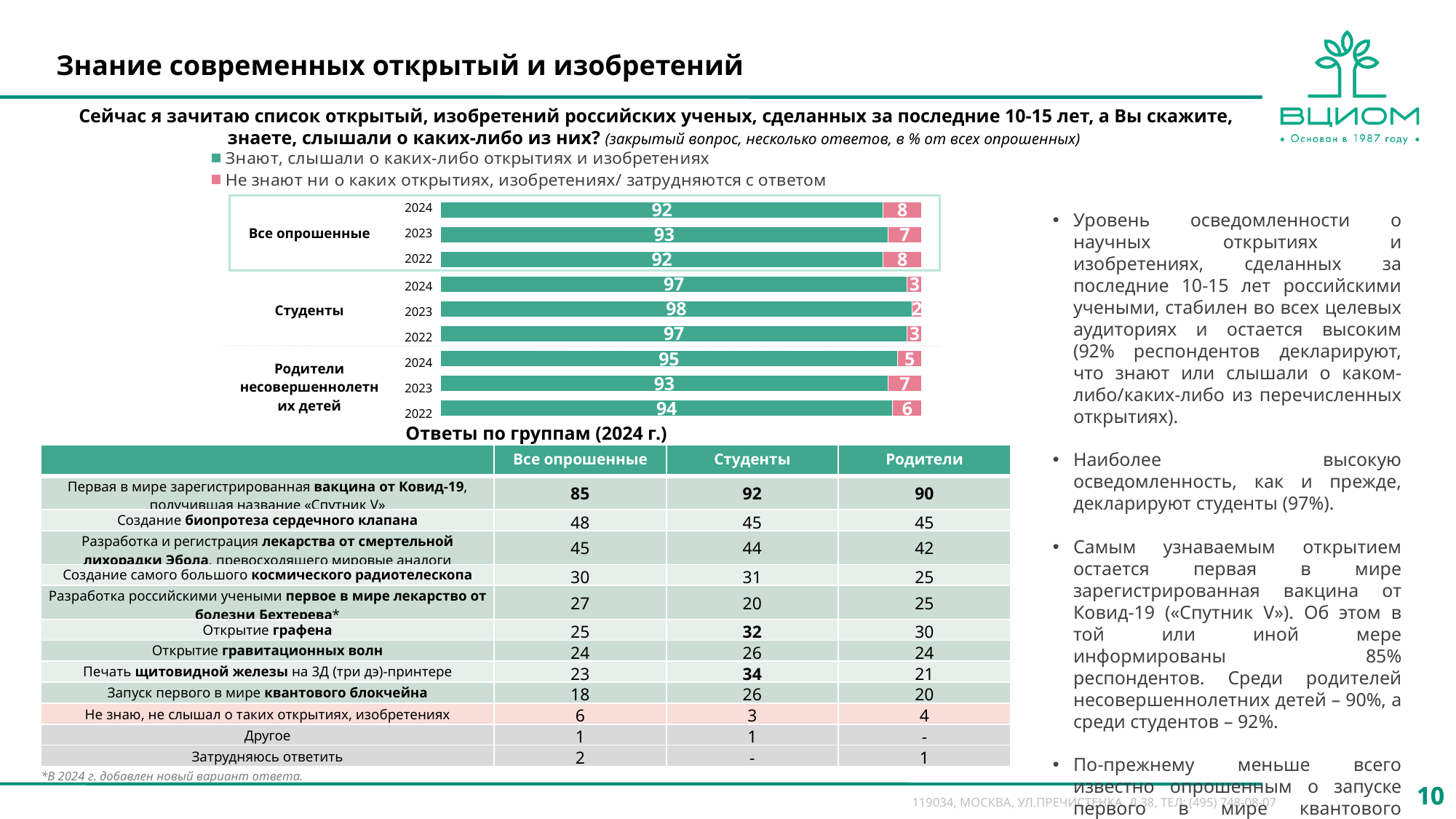
How many series does the chart legend list? 2 What is the value for "Знают, слышали о каких-либо открытиях и изобретениях" for Родители несовершеннолетних детей in 2022? 94 What colour represents the series "Не знают ни о каких открытиях, изобретениях/ затрудняются с ответом"? pink What is the total of the stacked bar for Все опрошенные in 2023? 100 How many bars are plotted in the chart? 9 What is the value for "Знают, слышали о каких-либо открытиях и изобретениях" for Все опрошенные in 2024? 92 Which is larger: the "Знают" value for Родители несовершеннолетних детей in 2024 or in 2023? 2024 What kind of chart is shown on the slide? bar chart What is the difference between the "Знают" values for Студенты 2024 and Все опрошенные 2024? 5 What is the value for "Не знают ни о каких открытиях, изобретениях/ затрудняются с ответом" for Студенты in 2023? 2 Which group and year has the highest value for "Знают, слышали о каких-либо открытиях и изобретениях"? Студенты, 2023 Which group and year has the lowest value for "Не знают ни о каких открытиях, изобретениях/ затрудняются с ответом"? Студенты, 2023